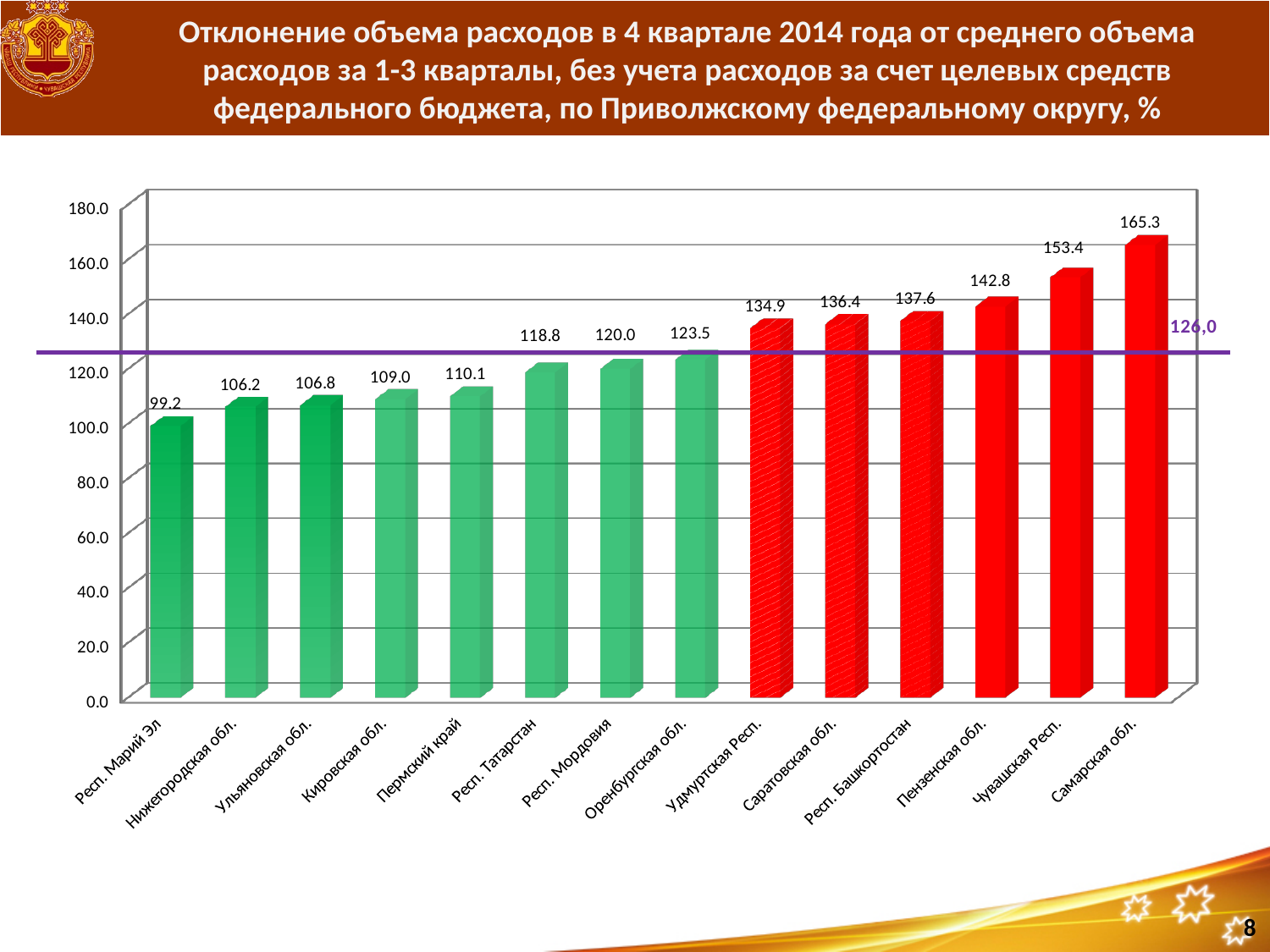
Which has a larger value, Саратовская обл. or Удмуртская Респ.? Саратовская обл. What type of chart is shown on the slide? bar chart Which region has the highest value? Самарская обл. What is the difference between the values for Чувашская Респ. and Пензенская обл.? 10.6 What is the difference between the values for Самарская обл. and Респ. Марий Эл? 66.1 What value is marked by the horizontal purple line across the chart? 126,0 What is the value for Чувашская Респ.? 153.4 How many regions are plotted on the chart? 14 What is the value for Кировская обл.? 109.0 Which region has the lowest value? Респ. Марий Эл Do the values rise or fall from left to right along the x axis? rise What is the value for Респ. Татарстан? 118.8